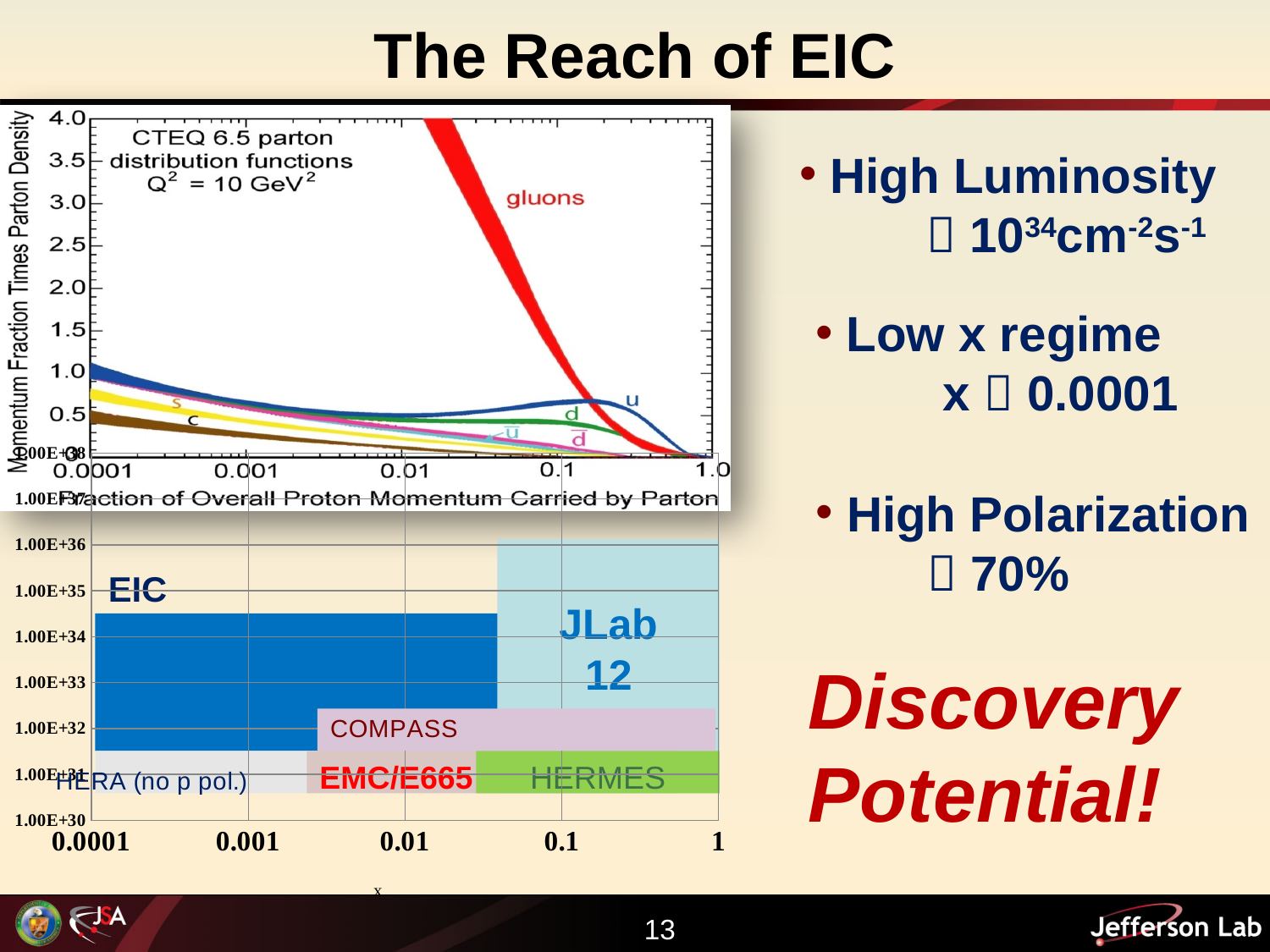
In the top chart, does the gluons curve rise or fall as x increases from 0.01 to 1.0? fall In the bottom chart, which experiment region reaches the highest luminosity? JLab 12 In the bottom chart, is the upper luminosity bound of the EIC region greater or less than 1.00E+34? greater What kind of chart is the top chart (CTEQ 6.5 parton distribution functions)? line chart In the top chart, what value of Q² is stated in the chart annotation? 10 GeV² In the top chart, which parton curve is drawn in red? gluons In the bottom chart, how many labeled experiment regions are shown? 6 In the top chart, which parton curve has the highest value at x = 0.01? gluons In the top chart, how many labeled parton curves are shown? 7 In the bottom chart, what is the lowest tick value on the x axis? 0.0001 In the top chart, what is the highest tick value on the y axis? 4.0